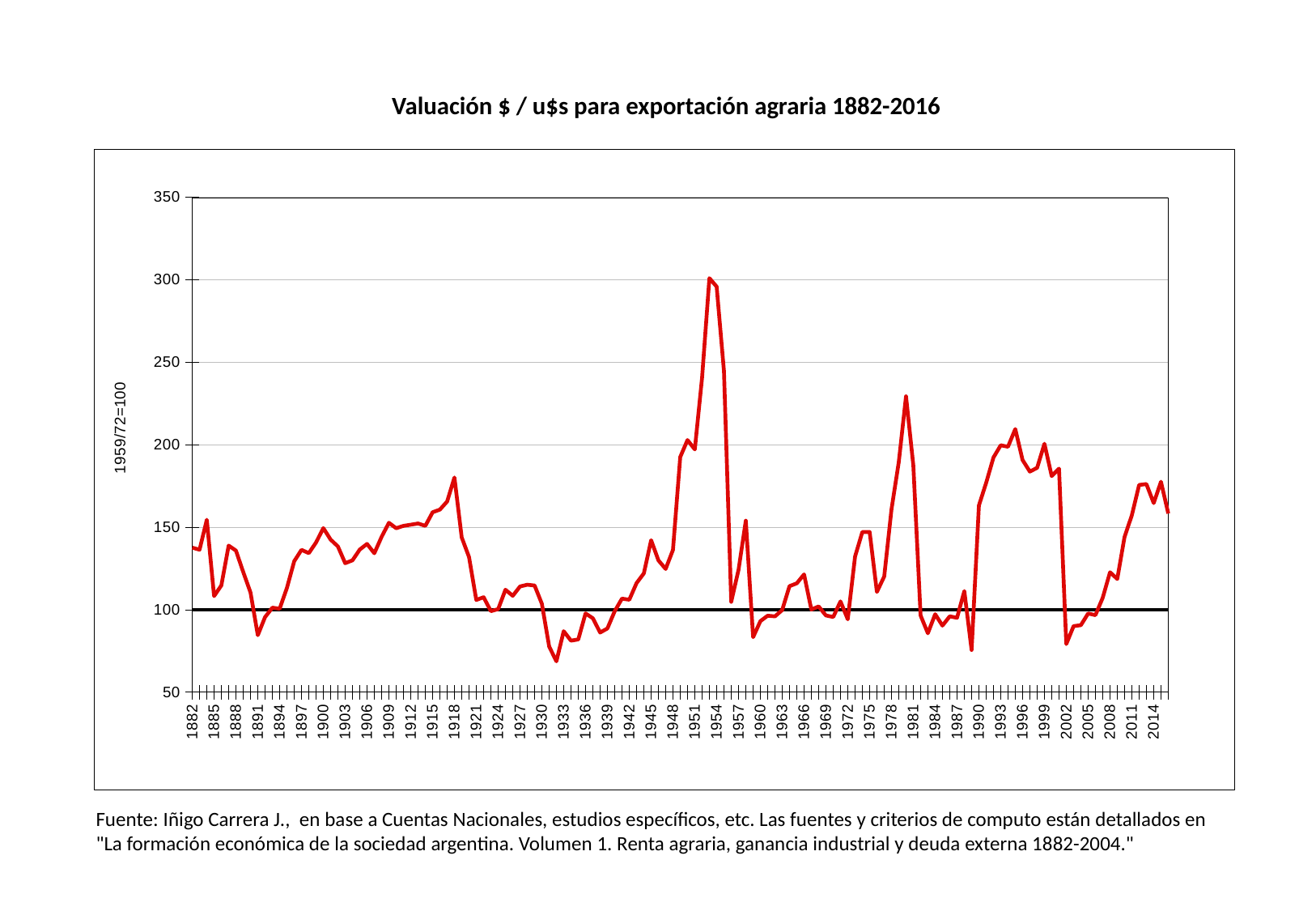
Is the value for 2002 greater or less than 100? less What is the label on the vertical axis of the chart? 1959/72=100 What is the title of the chart? Valuación $ / u$s para exportación agraria 1882-2016 What kind of chart is shown on the slide? line chart Is the value for 2014 greater or less than 150? greater Does the value rise or fall from 1951 to 1954? rise Is the value for 1882 greater or less than 100? greater Which is larger, the value for 1954 or the value for 1980? 1954